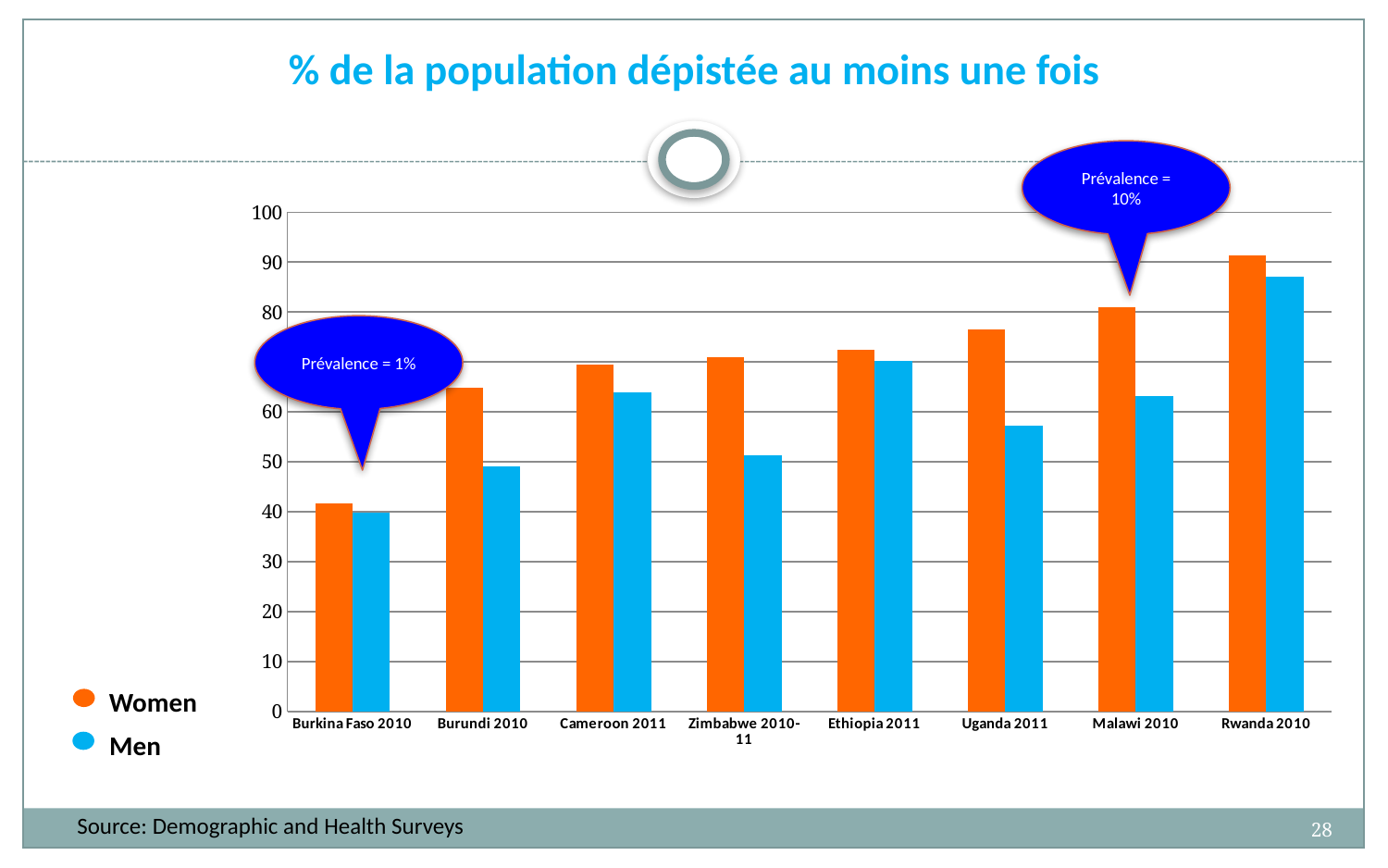
How many countries (categories) are shown on the x axis of the chart? 8 Is the value for Men in Ethiopia 2011 greater or less than 60? greater Is the value for Women in Rwanda 2010 greater or less than 80? greater In Zimbabwe 2010-11, which is larger, the value for Women or the value for Men? Women Which is larger, the value for Men in Cameroon 2011 or the value for Men in Uganda 2011? Cameroon 2011 What kind of chart is shown on the slide? bar chart Which country has the highest value for Women? Rwanda 2010 Which colour represents the Men series in the chart? blue Is the value for Men in Zimbabwe 2010-11 greater or less than 60? less How many series does the legend list? 2 Which country has the lowest value for Men? Burkina Faso 2010 Do the values for Women rise or fall from left to right along the x axis? rise